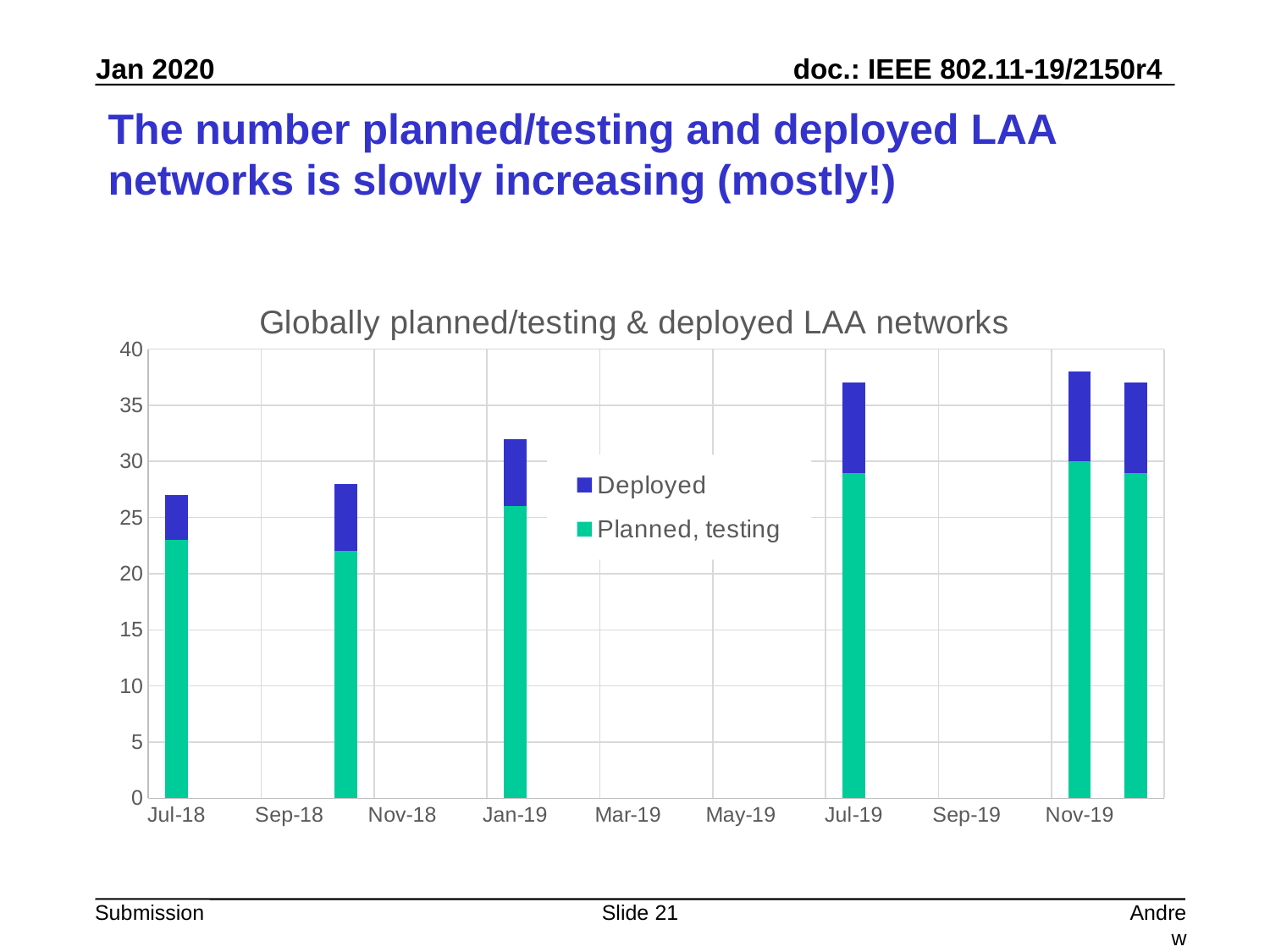
Do the total bar heights generally rise or fall from Jul-18 to Nov-19? rise What kind of chart is shown on the slide? Stacked bar chart Is the total height of the Jul-18 bar greater or less than 25? greater Is the Planned, testing value for Jul-18 greater or less than 25? less Is the total height of the Jul-19 bar greater or less than 35? greater How many series does the legend list? 2 How many stacked bars are plotted in the chart? 6 Which series is shown in green? Planned, testing What is the title of the chart? Globally planned/testing & deployed LAA networks Which bar is taller in total, Jul-18 or Jul-19? Jul-19